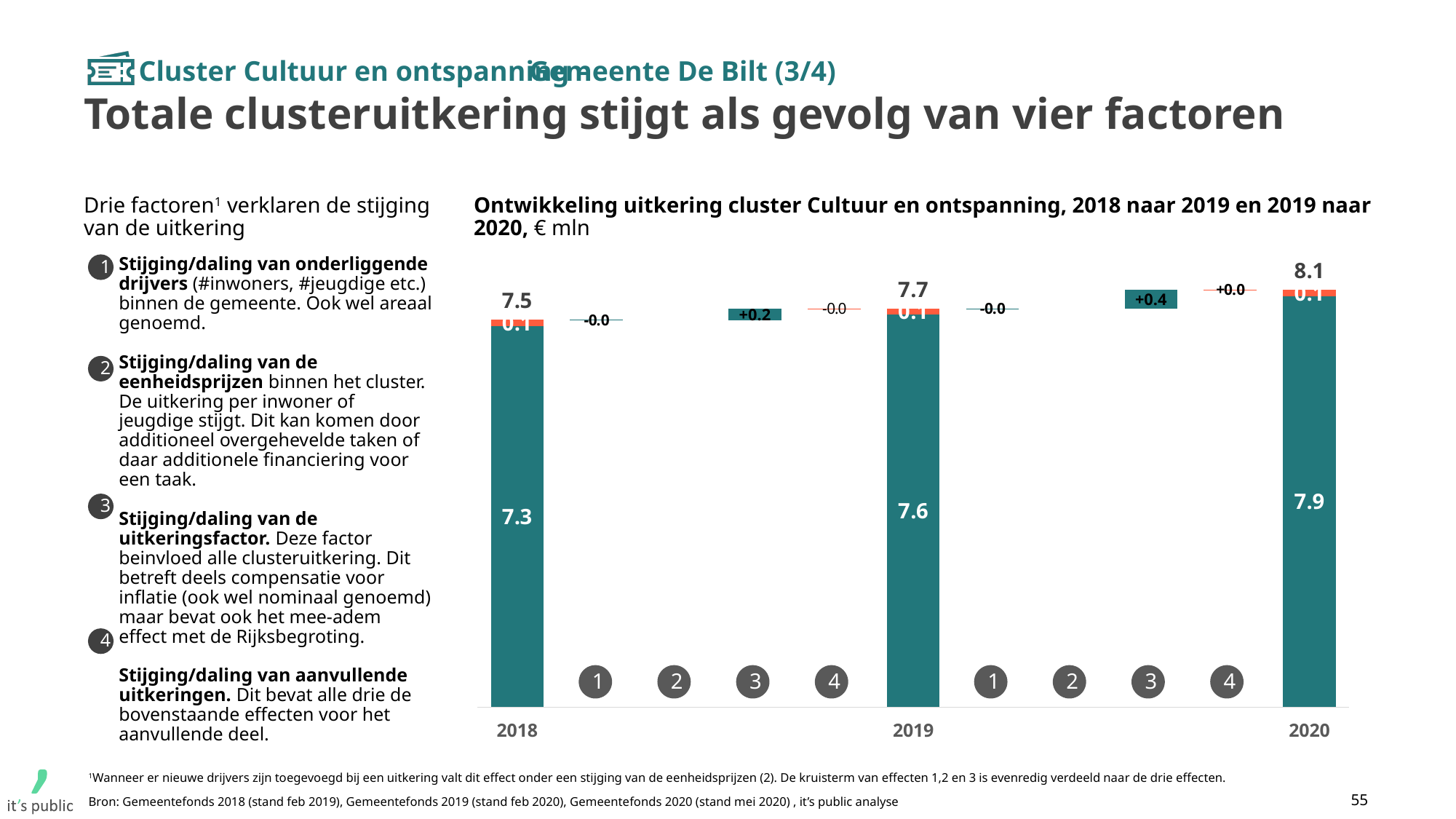
Which year has the lowest total uitkering? 2018 What is the total uitkering shown above the 2020 bar? 8.1 Which year has the highest total uitkering? 2020 What is the value of the large dark segment of the 2020 bar? 7.9 What is the value of the large dark segment of the 2019 bar? 7.6 Do the total uitkering values rise or fall from 2018 to 2020? rise What is the difference between the 2020 total (8.1) and the 2018 total (7.5)? 0.6 What is the total uitkering shown above the 2018 bar? 7.5 What unit is stated in the chart title? € mln What is the total uitkering shown above the 2019 bar? 7.7